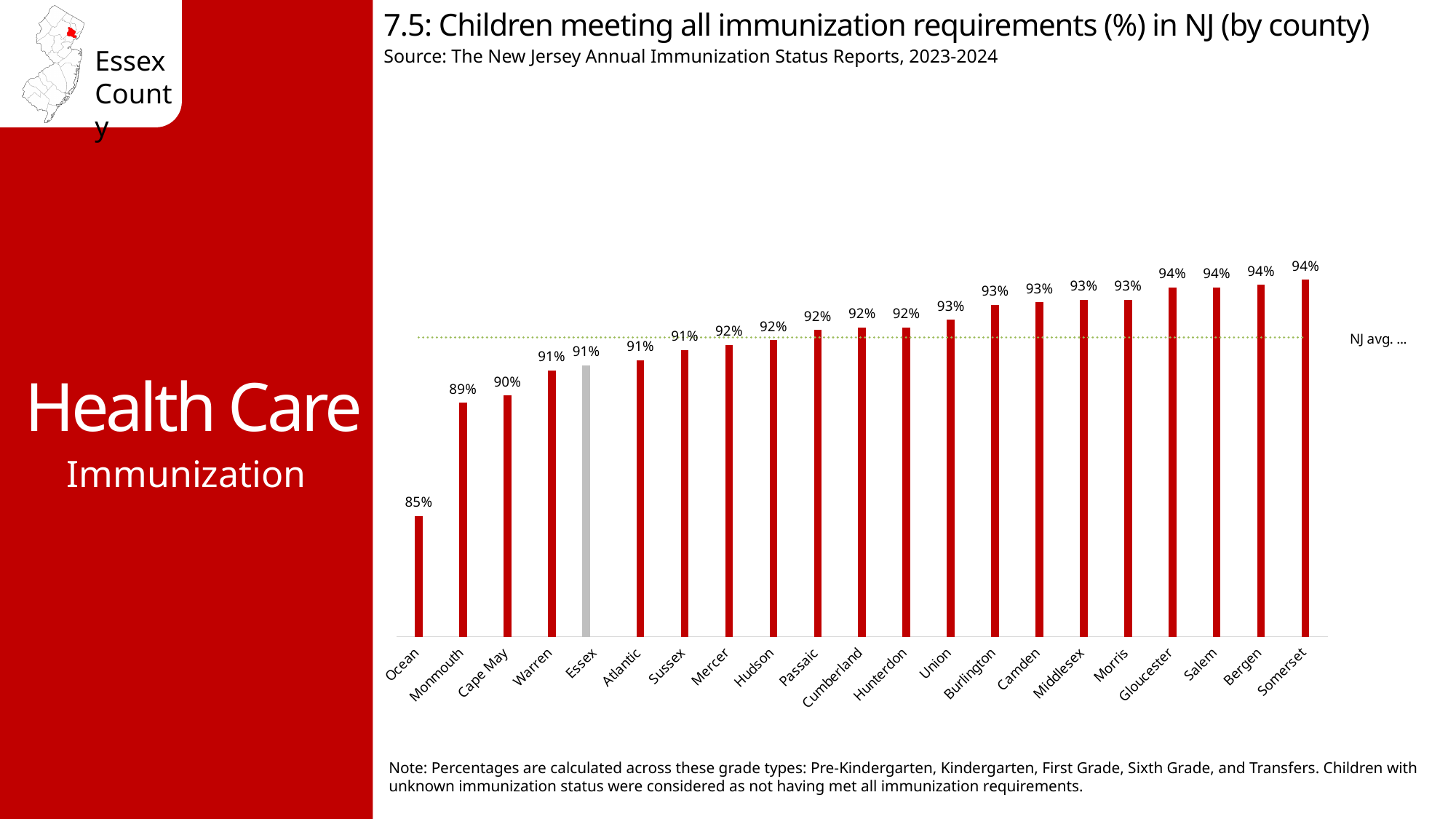
Which has a higher value, Essex or Morris? Morris Which county has the lowest percentage of children meeting all immunization requirements? Ocean What is the difference in percentage points between Somerset and Ocean? 9 percentage points What is the value for Cape May? 90% What is the difference in percentage points between Union and Essex? 2 percentage points Which has a higher value, Monmouth or Ocean? Monmouth Which county's bar is coloured grey instead of red? Essex What type of chart is shown on the slide? Bar chart What is the value shown for Ocean County? 85% What percentage is shown for Somerset County? 94% What percentage of children in Essex County met all immunization requirements? 91% How many counties are shown in the chart? 21